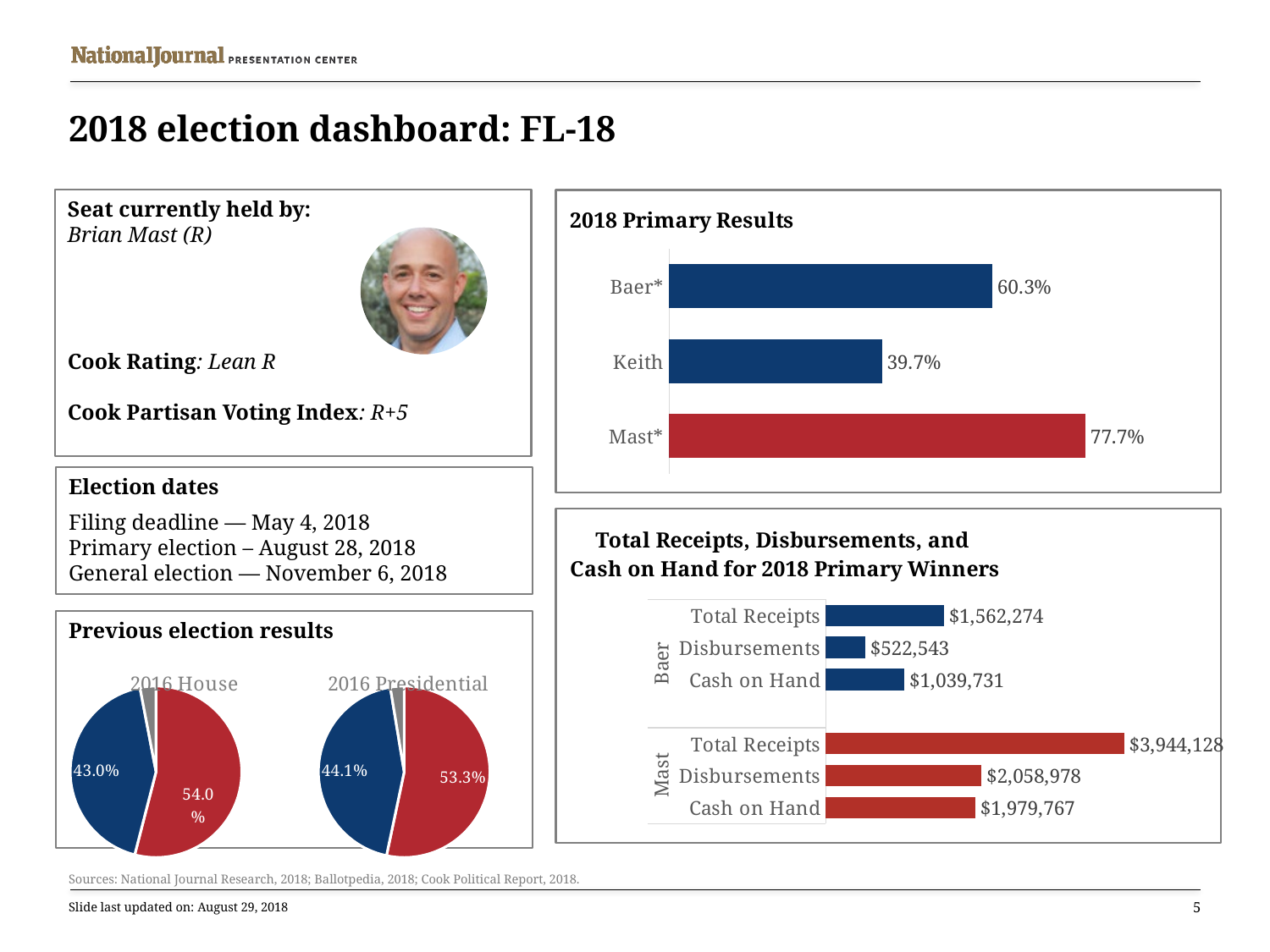
What type of chart is the 2018 Primary Results chart? Bar chart In the Total Receipts, Disbursements, and Cash on Hand chart, what is Baer's Cash on Hand? $1,039,731 In the Total Receipts, Disbursements, and Cash on Hand chart, what are Mast's Total Receipts? $3,944,128 In the 2018 Primary Results chart, what percentage did Keith receive? 39.7% In the 2016 House pie chart under Previous election results, what share does the largest slice represent? 54.0% In the Total Receipts, Disbursements, and Cash on Hand chart, which is larger: Mast's Disbursements or Baer's Total Receipts? Mast's Disbursements How many candidates are shown in the 2018 Primary Results chart? 3 In the 2018 Primary Results chart, what percentage did Mast* receive? 77.7% In the 2018 Primary Results chart, what is the difference in percentage points between Baer* and Keith? 20.6 In the Total Receipts, Disbursements, and Cash on Hand chart, which value is the smallest? Baer Disbursements ($522,543) In the Total Receipts, Disbursements, and Cash on Hand chart, how much larger are Mast's Total Receipts than Baer's Total Receipts? $2,381,854 In the 2018 Primary Results chart, which candidate has the lowest percentage? Keith